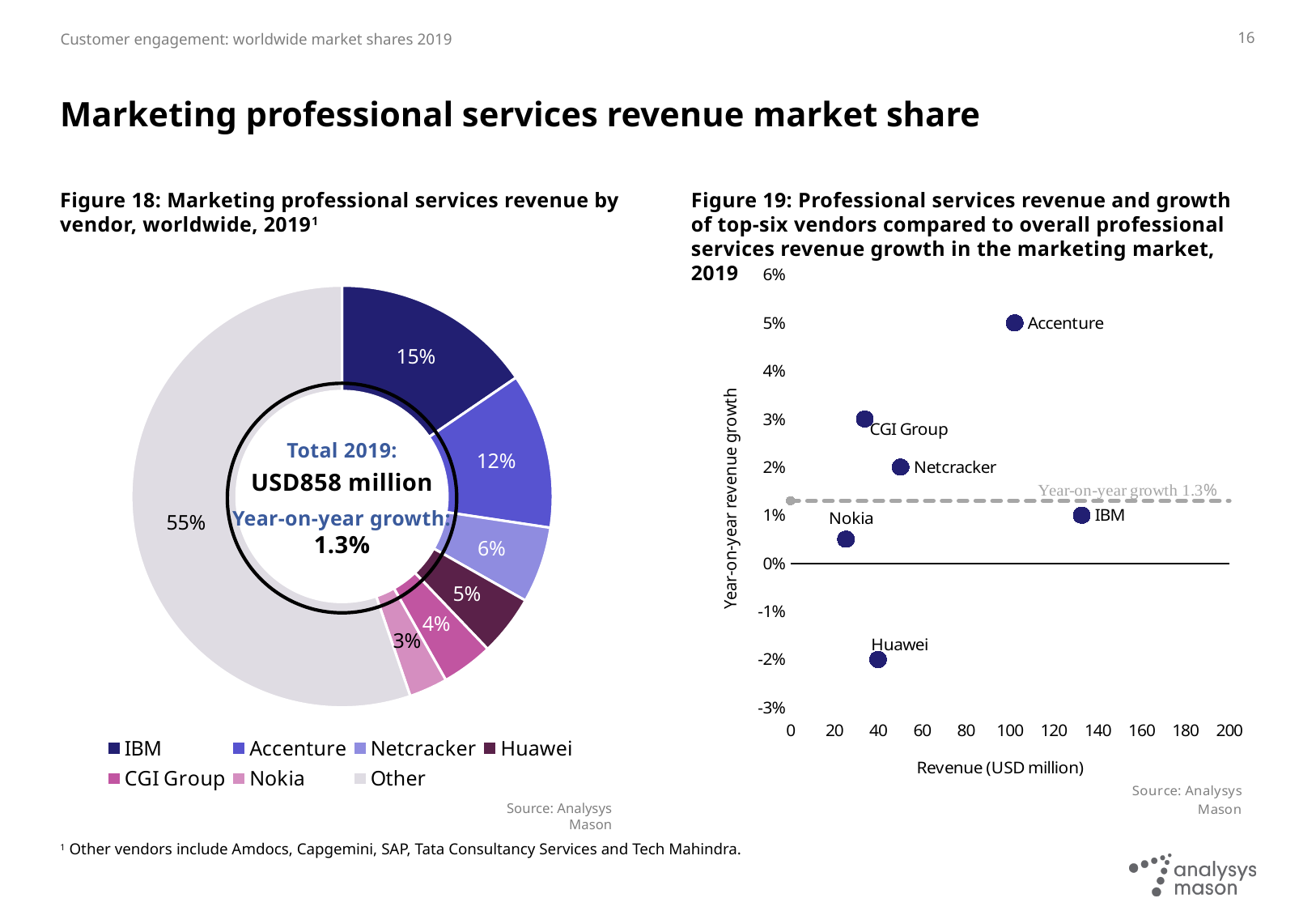
In Figure 19, which vendor has the lowest year-on-year revenue growth? Huawei In Figure 18, what share of marketing professional services revenue does IBM hold? 15% In Figure 18, which named vendor (excluding Other) has the largest share? IBM What kind of chart is Figure 19? Scatter chart In Figure 18, what share does Nokia hold? 3% In Figure 18, which vendor has the smallest share? Nokia In Figure 18, which has the larger share, Netcracker or Huawei? Netcracker In Figure 18, what share does Accenture hold? 12% In Figure 18, what is the total 2019 marketing professional services revenue shown in the centre of the chart? USD858 million In Figure 18, how many segments does the donut chart have? 7 In Figure 19, is Accenture's year-on-year revenue growth greater or less than 4%? greater In Figure 18, what is the difference in percentage points between IBM's share and Accenture's share? 3 percentage points